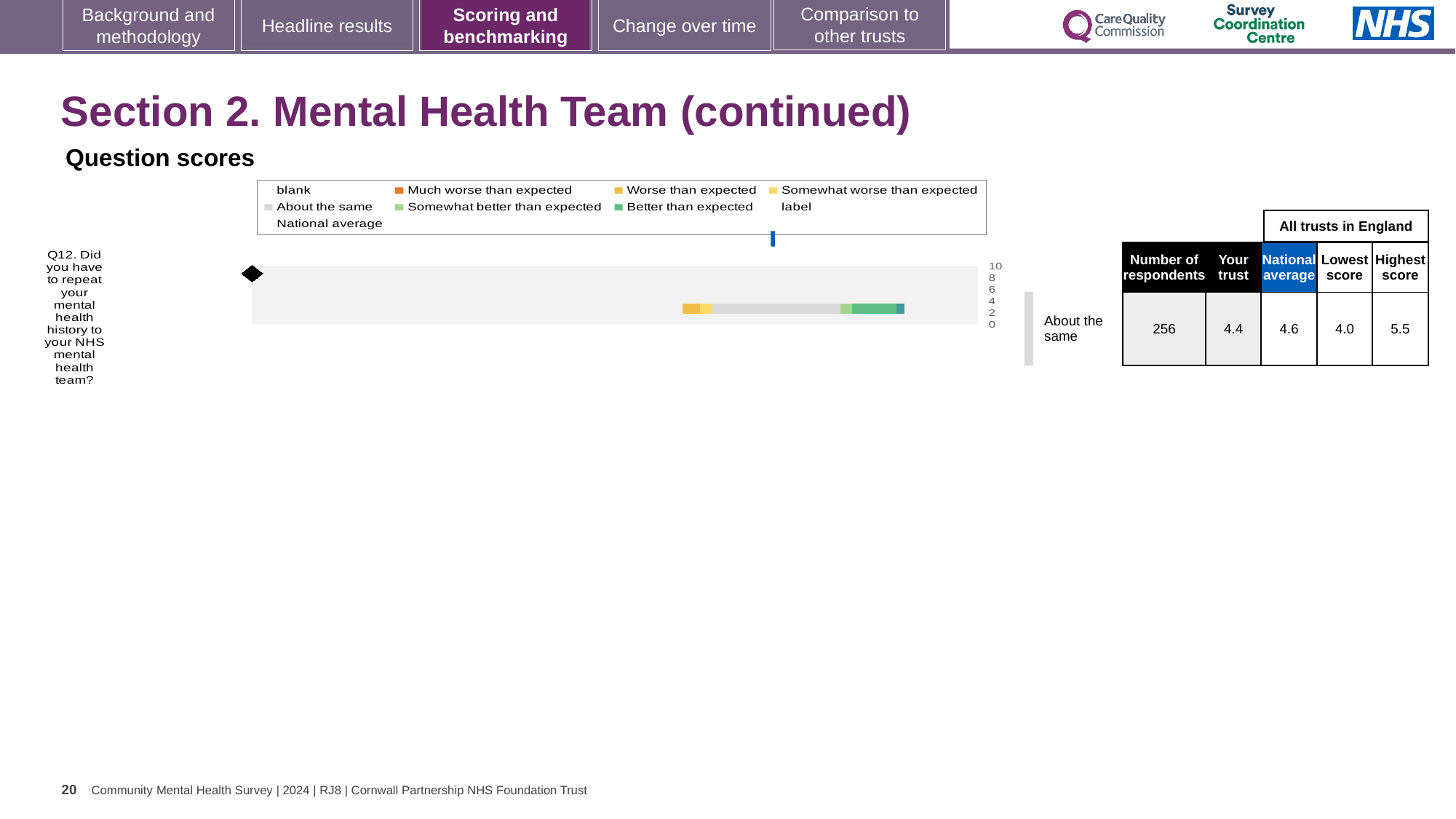
What is the lowest score among all trusts in England for Q12? 4.0 How many questions are plotted on the chart? 1 Which is larger for Q12, the 'Your trust' score or the national average? National average How many respondents answered Q12 according to the table? 256 What is the national average score for Q12? 4.6 What is the highest score among all trusts in England for Q12? 5.5 What kind of chart is used to show the Q12 question score? bar chart What is the maximum value shown on the chart's score axis? 10 What is the 'Your trust' score for Q12? 4.4 By how much does the national average exceed the 'Your trust' score for Q12? 0.2 What benchmark category is shown next to the Q12 chart? About the same What is the difference between the highest score and the lowest score for Q12? 1.5